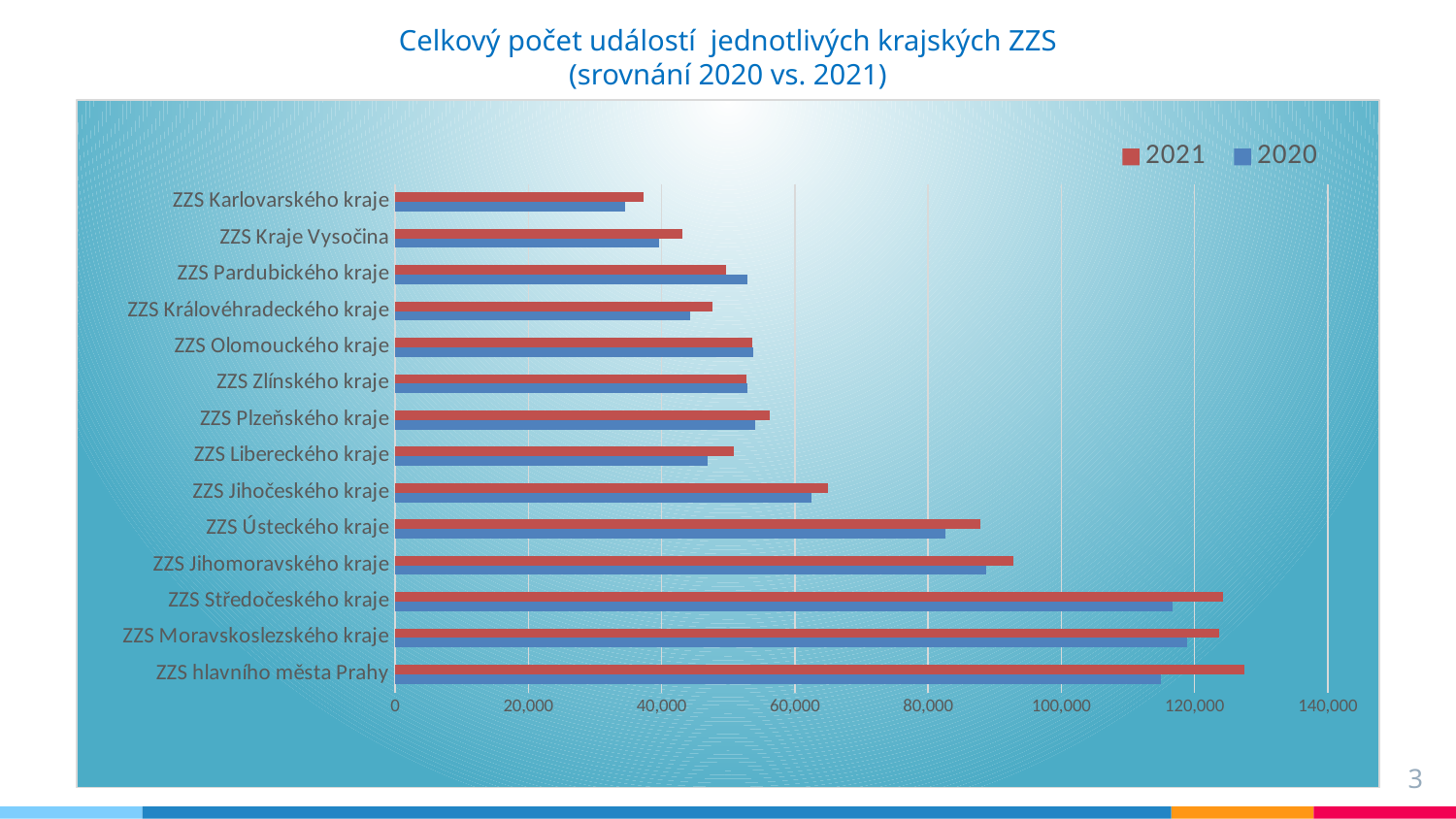
What is the title of the chart? Celkový počet událostí jednotlivých krajských ZZS (srovnání 2020 vs. 2021) How many regional ZZS categories are plotted on the chart? 14 Is the 2020 value for ZZS Středočeského kraje greater or less than 120,000? less Which series is shown in red in the legend? 2021 Which has the larger 2021 value, ZZS Jihomoravského kraje or ZZS Jihočeského kraje? ZZS Jihomoravského kraje Is the 2020 value for ZZS Karlovarského kraje greater or less than 40,000? less How many series does the legend list? 2 Is the 2021 value for ZZS Ústeckého kraje greater or less than 80,000? greater Which category has the lowest value for 2021? ZZS Karlovarského kraje What kind of chart is shown on the slide? bar chart Which category has the lowest value for 2020? ZZS Karlovarského kraje